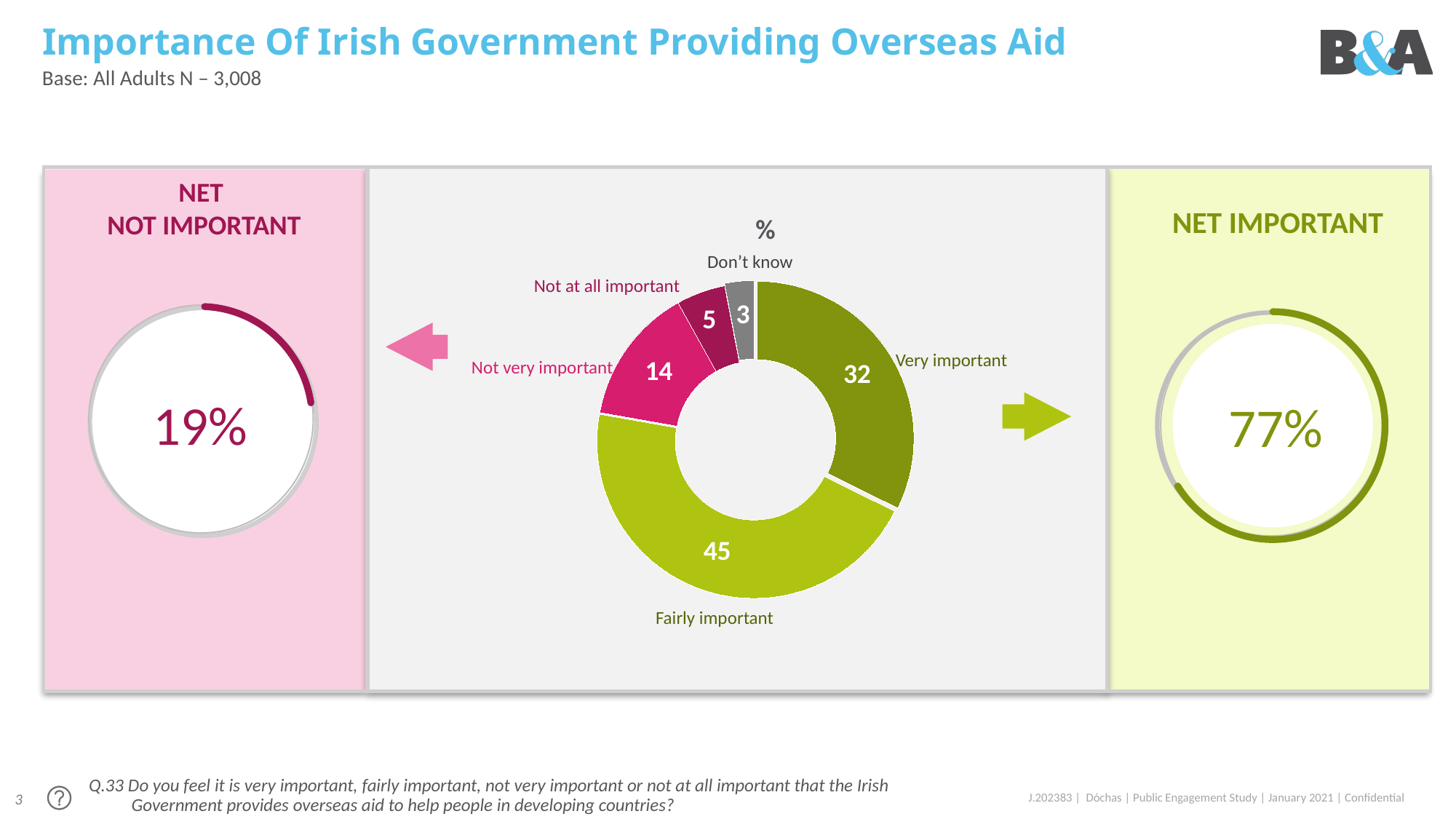
Which is larger in the donut chart: 'Not very important' or 'Not at all important'? Not very important Which category has the smallest share of the donut chart? Don't know What is the NET IMPORTANT figure shown on the right of the slide? 77% How many categories are shown in the donut chart? 5 What value is shown for 'Very important' in the donut chart? 32 Which category has the largest share of the donut chart? Fairly important What value is shown for 'Not very important' in the donut chart? 14 What is the NET NOT IMPORTANT figure shown on the left of the slide? 19% What type of chart is shown in the centre of the slide? Donut (pie) chart What is the difference between the 'Fairly important' and 'Very important' values in the donut chart? 13 What percentage of respondents said it is fairly important that the Irish Government provides overseas aid? 45 What value is shown for 'Don't know' in the donut chart? 3